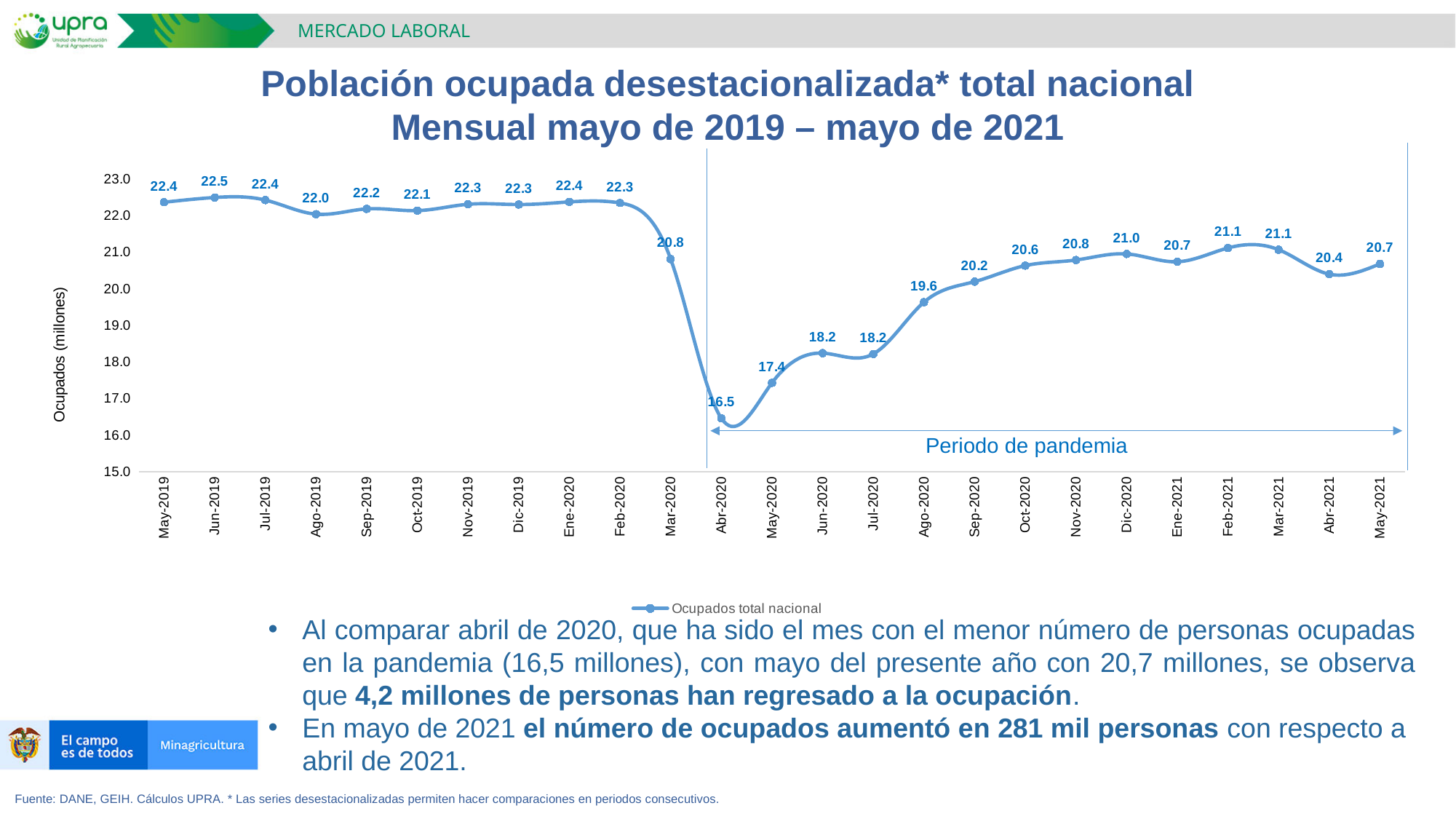
Which month has the lowest value? Abr-2020 How many monthly data points are plotted on the chart? 25 What is the label of the y axis? Ocupados (millones) What is the difference between the values for May-2021 and Abr-2020? 4.2 What is the difference between the values for Feb-2020 and Mar-2020? 1.5 What is the value for Abr-2020? 16.5 Which is larger, the value for Dic-2020 or the value for Abr-2021? Dic-2020 What is the value for Mar-2020? 20.8 What type of chart is shown on the slide? line chart What is the value for May-2021? 20.7 Which month has the highest value? Jun-2019 How many series does the legend list? 1